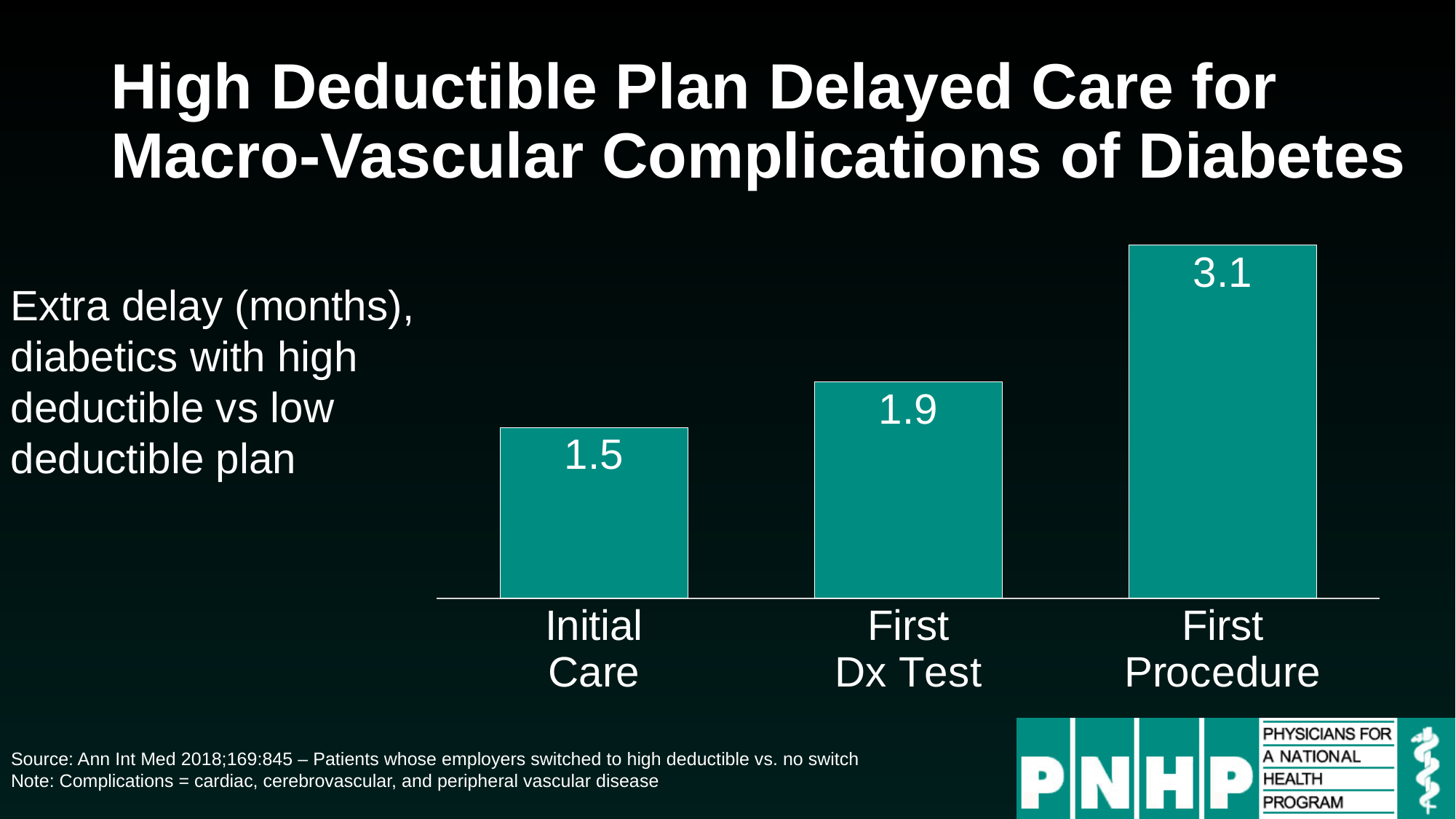
Do the values rise or fall from Initial Care to First Procedure? Rise What is the extra delay in months for Initial Care? 1.5 What is the difference in extra delay between First Dx Test and Initial Care? 0.4 Which category has the lowest extra delay? Initial Care What unit is the extra delay measured in, according to the slide? Months What is the difference in extra delay between First Procedure and Initial Care? 1.6 Which category has the highest extra delay? First Procedure What is the extra delay in months for First Dx Test? 1.9 Which has a larger extra delay, First Dx Test or First Procedure? First Procedure What is the extra delay in months for First Procedure? 3.1 How many categories are shown in the chart? 3 What kind of chart is shown on the slide? Bar chart